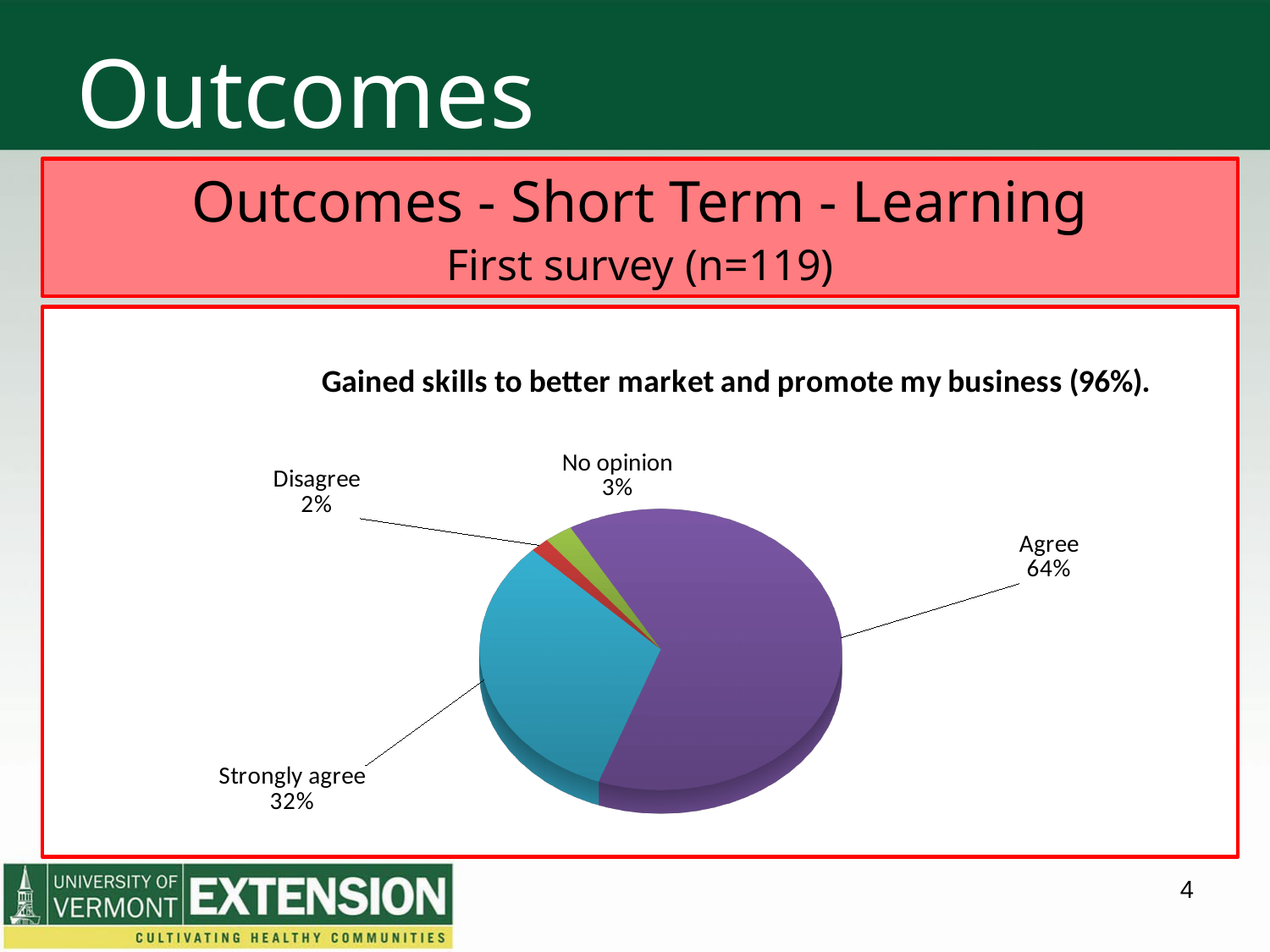
What kind of chart is shown on the slide? Pie chart Which response category has the smallest share of the pie? Disagree Which response category has the largest share of the pie? Agree What is the difference in percentage points between "Agree" and "Strongly agree"? 32 What is the title of the pie chart? Gained skills to better market and promote my business (96%). How many slices does the pie chart have? 4 What percentage of respondents answered "Agree"? 64% What percentage of respondents answered "Disagree"? 2% What percentage of respondents answered "Strongly agree"? 32% What is the combined share of "Agree" and "Strongly agree"? 96% Which is larger, the share for "No opinion" or the share for "Disagree"? No opinion What percentage of respondents answered "No opinion"? 3%